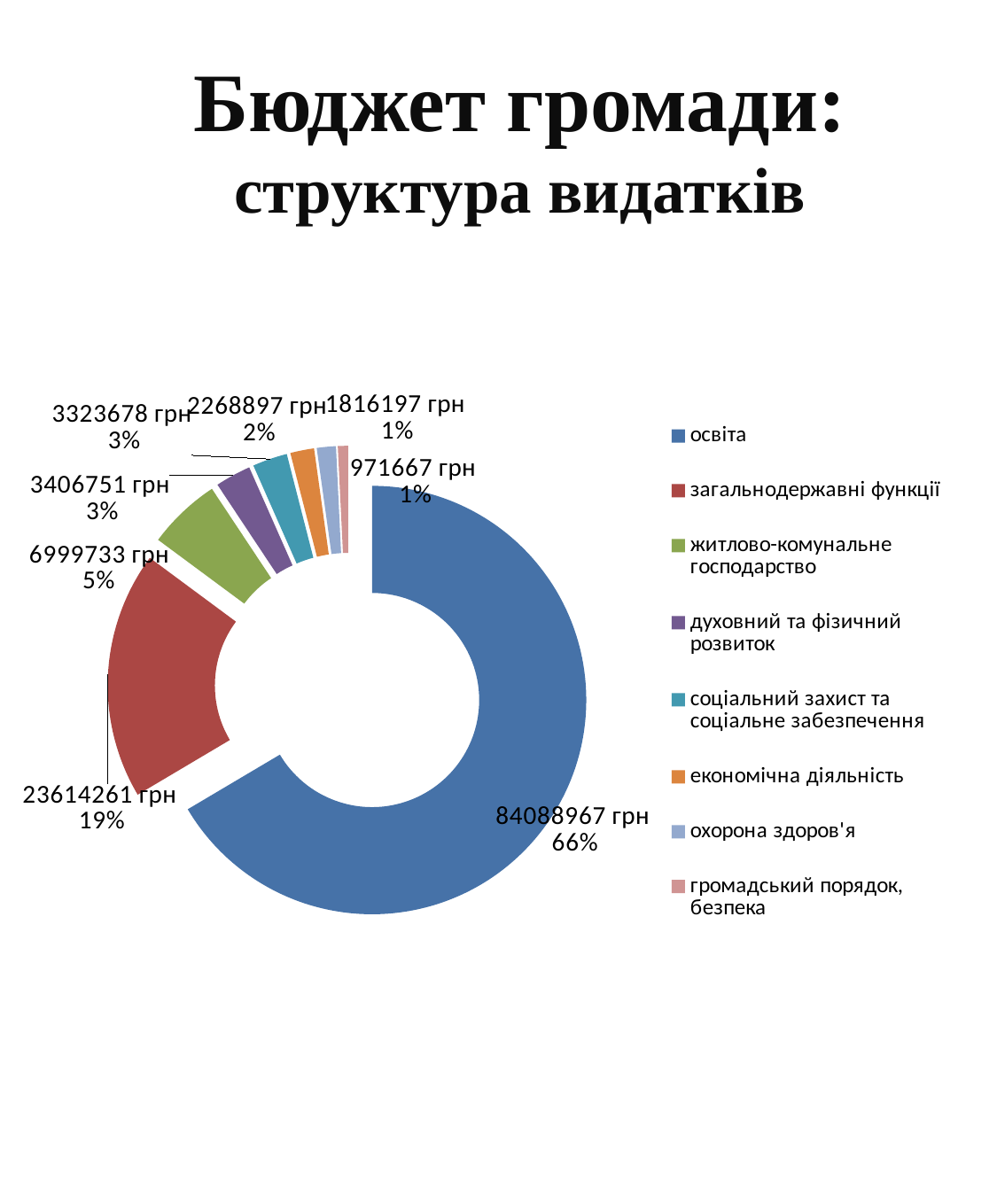
What is the value shown for загальнодержавні функції? 23614261 грн What percentage share does загальнодержавні функції have in the chart? 19% What kind of chart is shown on the slide? Doughnut (pie) chart What is the value shown for житлово-комунальне господарство? 6999733 грн Which category has the largest slice in the chart? освіта Which is larger: загальнодержавні функції or житлово-комунальне господарство? загальнодержавні функції What is the title of the slide containing the chart? Бюджет громади: структура видатків Which category has the smallest slice in the chart? громадський порядок, безпека What is the value shown for освіта? 84088967 грн How many categories does the legend list? 8 What is the difference between the values for освіта and загальнодержавні функції? 60474706 грн What percentage share does освіта have in the chart? 66%